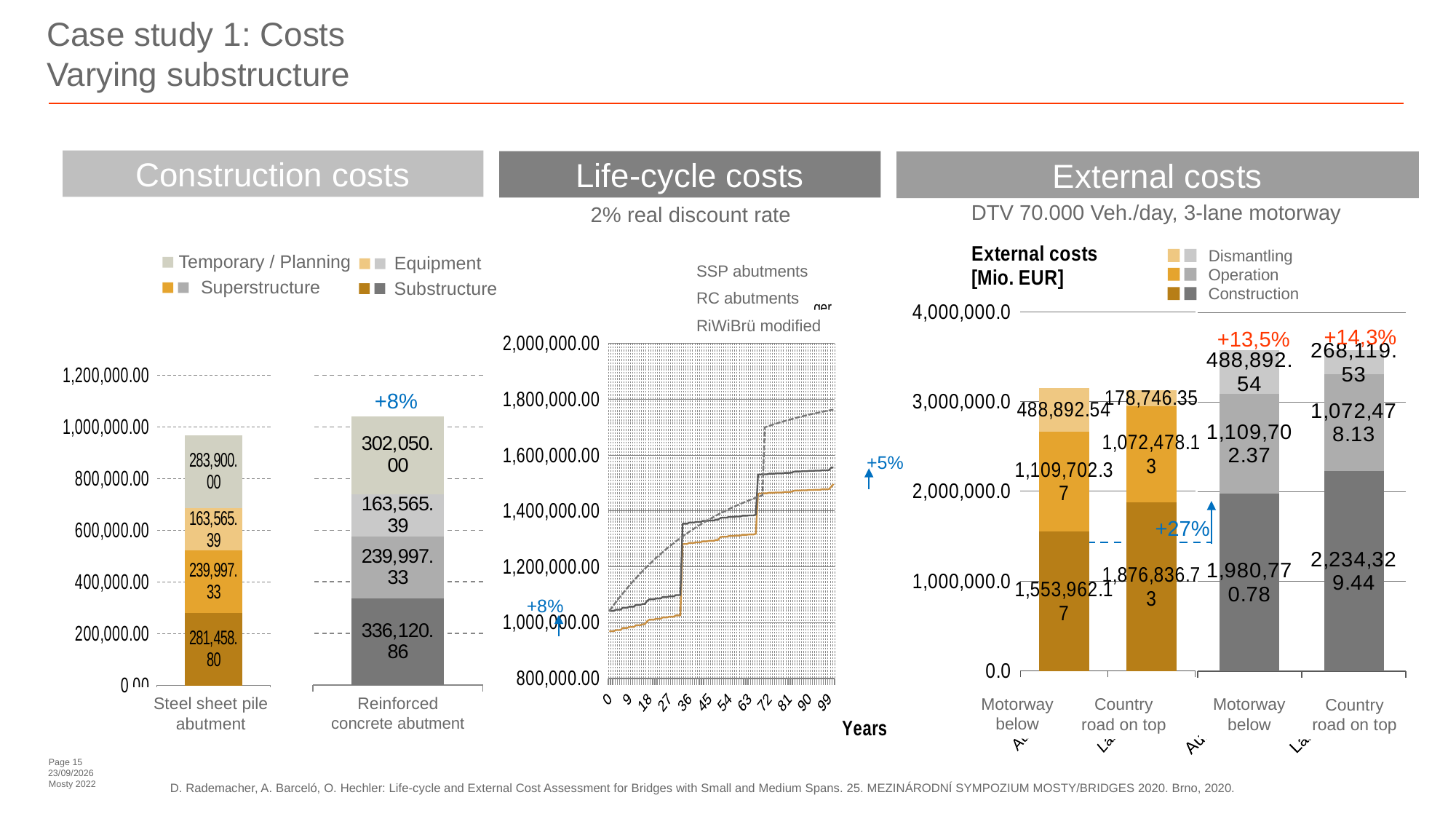
In the External costs chart, what is the Construction value for the rightmost Country road on top bar? 2,234,329.44 In the Construction costs chart, what is the Temporary / Planning value for the Reinforced concrete abutment? 302,050.00 What kind of chart is the Construction costs chart? bar chart In the Construction costs chart, which bar is taller, Steel sheet pile abutment or Reinforced concrete abutment? Reinforced concrete abutment In the Construction costs chart, what is the difference between the Substructure values of the Reinforced concrete abutment and the Steel sheet pile abutment? 54,662.06 In the Construction costs chart, what is the Substructure value for the Steel sheet pile abutment? 281,458.80 In the Life-cycle costs chart, do the lines rise or fall as the years increase? rise How many series does the legend of the Construction costs chart list? 4 What kind of chart is the Life-cycle costs chart? line chart How many bars are plotted in the External costs chart? 4 What discount rate is stated under the Life-cycle costs heading? 2% real discount rate How many series does the legend of the Life-cycle costs chart list? 3